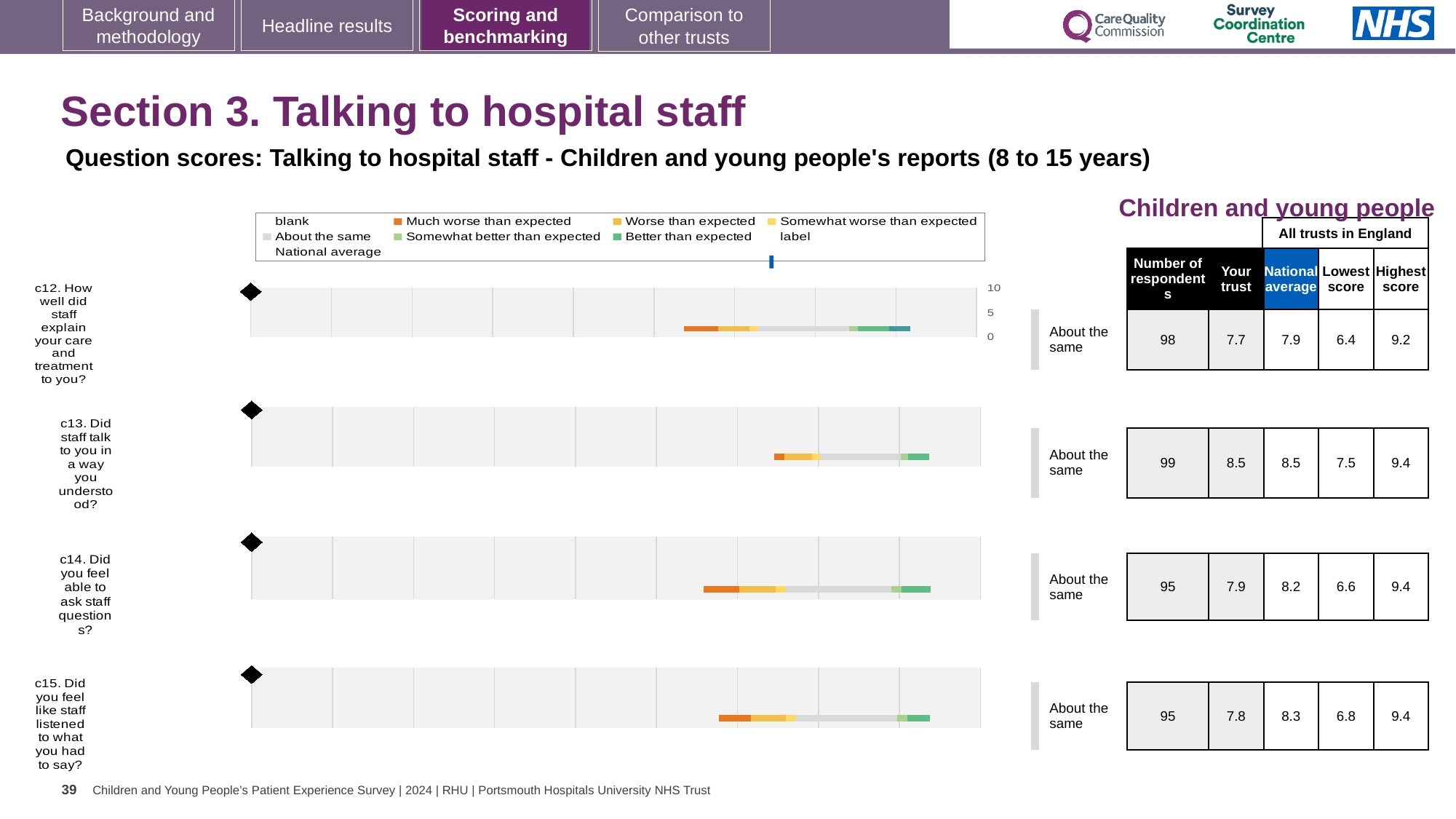
What kind of chart is used to show the question scores? Bar chart What is the 'Your trust' score for question c12 (How well did staff explain your care and treatment to you?)? 7.7 What is the highest score across all trusts in England for question c15 (Did you feel like staff listened to what you had to say?)? 9.4 What benchmark category is shown for question c12? About the same How many questions are charted on this slide? 4 What is the difference between the national average and the 'Your trust' score for question c15? 0.5 What is the national average score for question c14 (Did you feel able to ask staff questions?)? 8.2 How many respondents answered question c13 (Did staff talk to you in a way you understood?)? 99 Which question has the lowest 'Your trust' score? c12 Which question has the highest 'Your trust' score? c13 What is the lowest score across all trusts in England for question c12? 6.4 Which has the larger 'Your trust' score, question c14 or question c15? c14